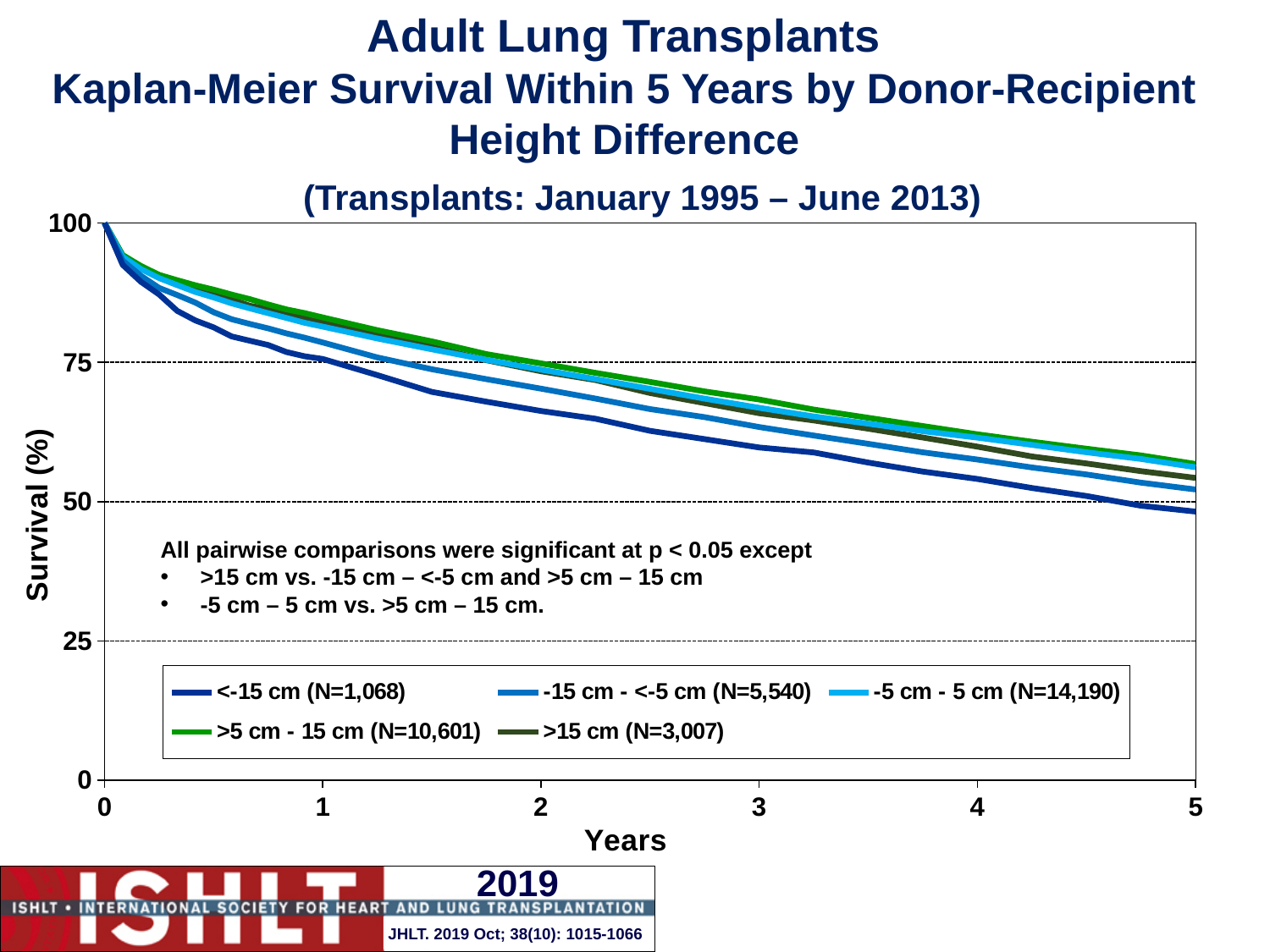
At 5 years, which group has higher survival: <-15 cm or -15 cm - <-5 cm? -15 cm - <-5 cm What kind of chart is shown on the slide? Line chart Is the survival for the >5 cm - 15 cm group at 5 years greater or less than 50? greater How many series does the legend list? 5 What is the label of the y axis? Survival (%) Is the survival for the <-15 cm group at 5 years greater or less than 50? less At 2 years, which group has higher survival: <-15 cm or >5 cm - 15 cm? >5 cm - 15 cm Do the survival curves rise or fall as years increase? Fall Is the survival for the <-15 cm group at 2 years greater or less than 75? less What is the N for the -5 cm - 5 cm group shown in the legend? 14,190 Which height-difference group has the lowest survival at 5 years? <-15 cm How many tick marks are labelled on the x axis (Years)? 6